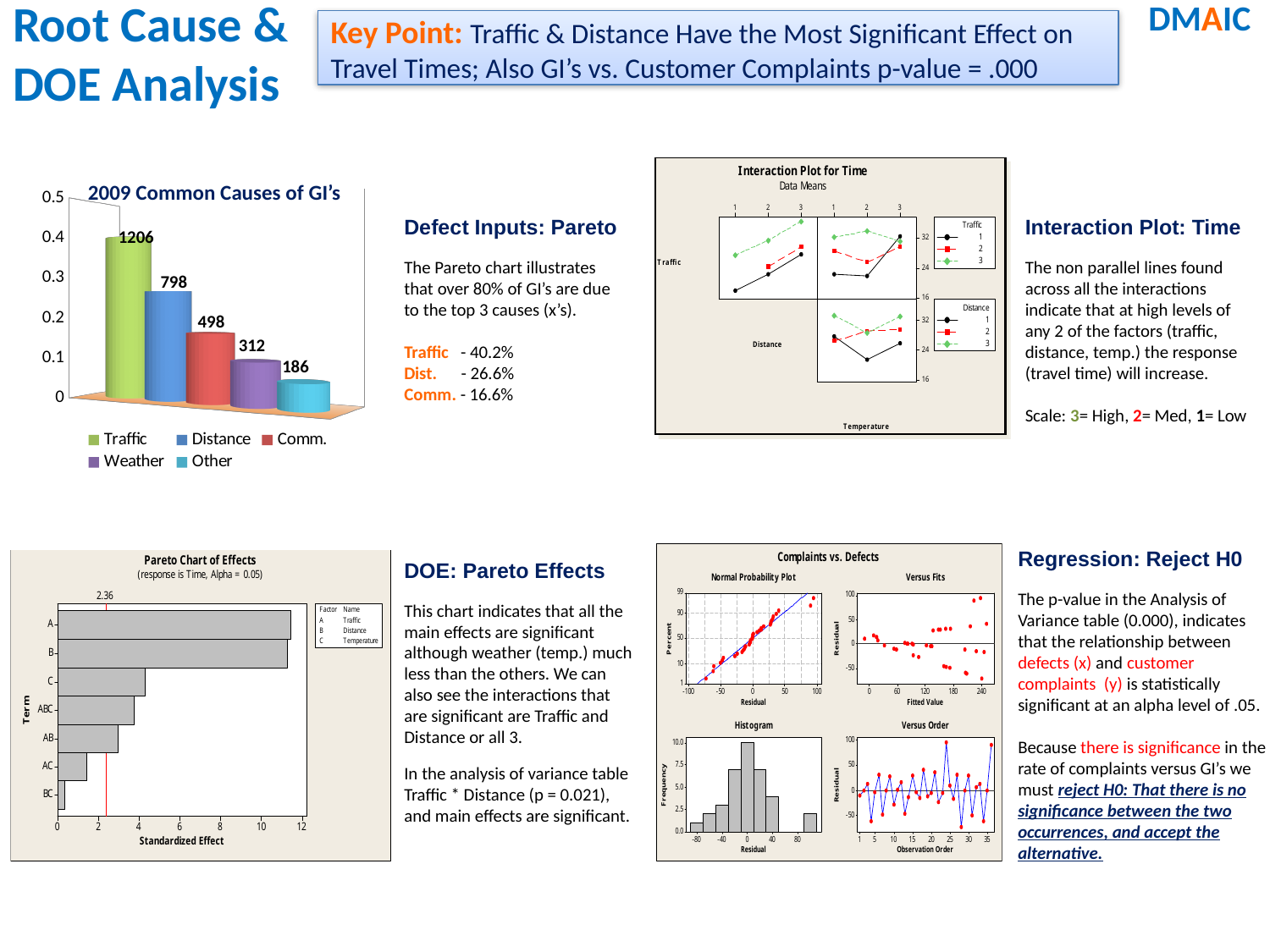
In the '2009 Common Causes of GI's' chart, which category has the lowest value? Other In the 'Pareto Chart of Effects' at the bottom left, how many terms are listed on the vertical axis? 7 In the '2009 Common Causes of GI's' chart, which category has the highest value? Traffic In the '2009 Common Causes of GI's' chart, what is the value for Other? 186 How many categories are shown in the '2009 Common Causes of GI's' chart? 5 In the 'Pareto Chart of Effects' at the bottom left, which factor name does the legend give for C? Temperature What kind of chart is the '2009 Common Causes of GI's' chart? Bar chart In the '2009 Common Causes of GI's' chart, which is larger, Distance or Comm.? Distance In the '2009 Common Causes of GI's' chart, what is the value for Traffic? 1206 In the '2009 Common Causes of GI's' chart, do the values rise or fall from left to right? Fall In the 'Pareto Chart of Effects' at the bottom left, is the standardized effect for term A greater or less than 10? greater In the '2009 Common Causes of GI's' chart, what is the difference between the Traffic and Distance values? 408